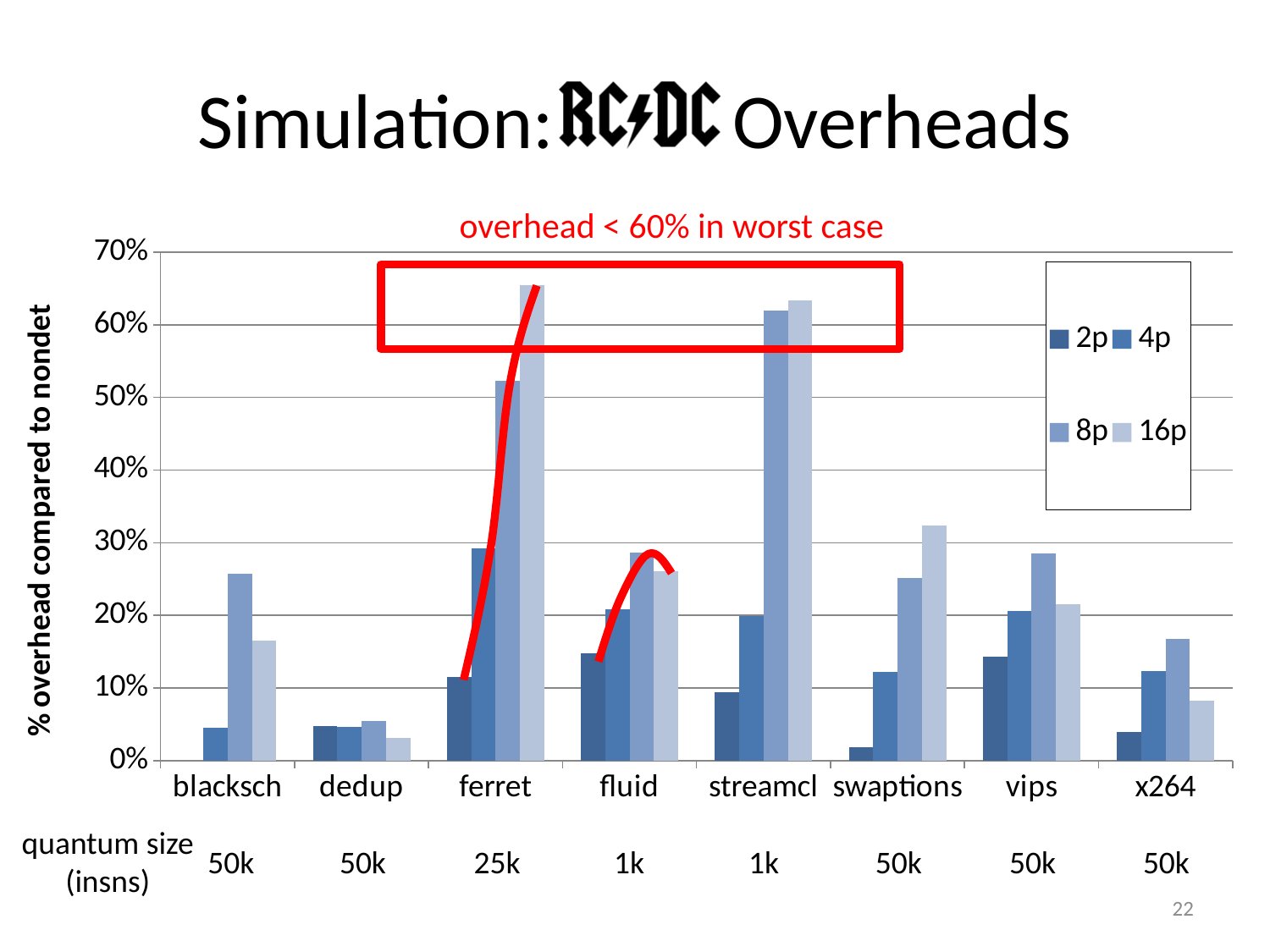
How many benchmark categories are shown along the x axis? 8 Which benchmark has the highest 8p overhead? streamcl Is the 16p overhead for dedup greater or less than 10%? less Is the 8p overhead for streamcl greater or less than 60%? greater What is the y-axis title of the chart? % overhead compared to nondet How many series does the legend list? 4 Is the 16p overhead for swaptions greater or less than 30%? greater Which is larger: the 8p overhead for ferret or the 8p overhead for fluid? ferret What quantum size (insns) is listed under ferret? 25k Which benchmark has the lowest 16p overhead? dedup What kind of chart is shown on the slide? bar chart